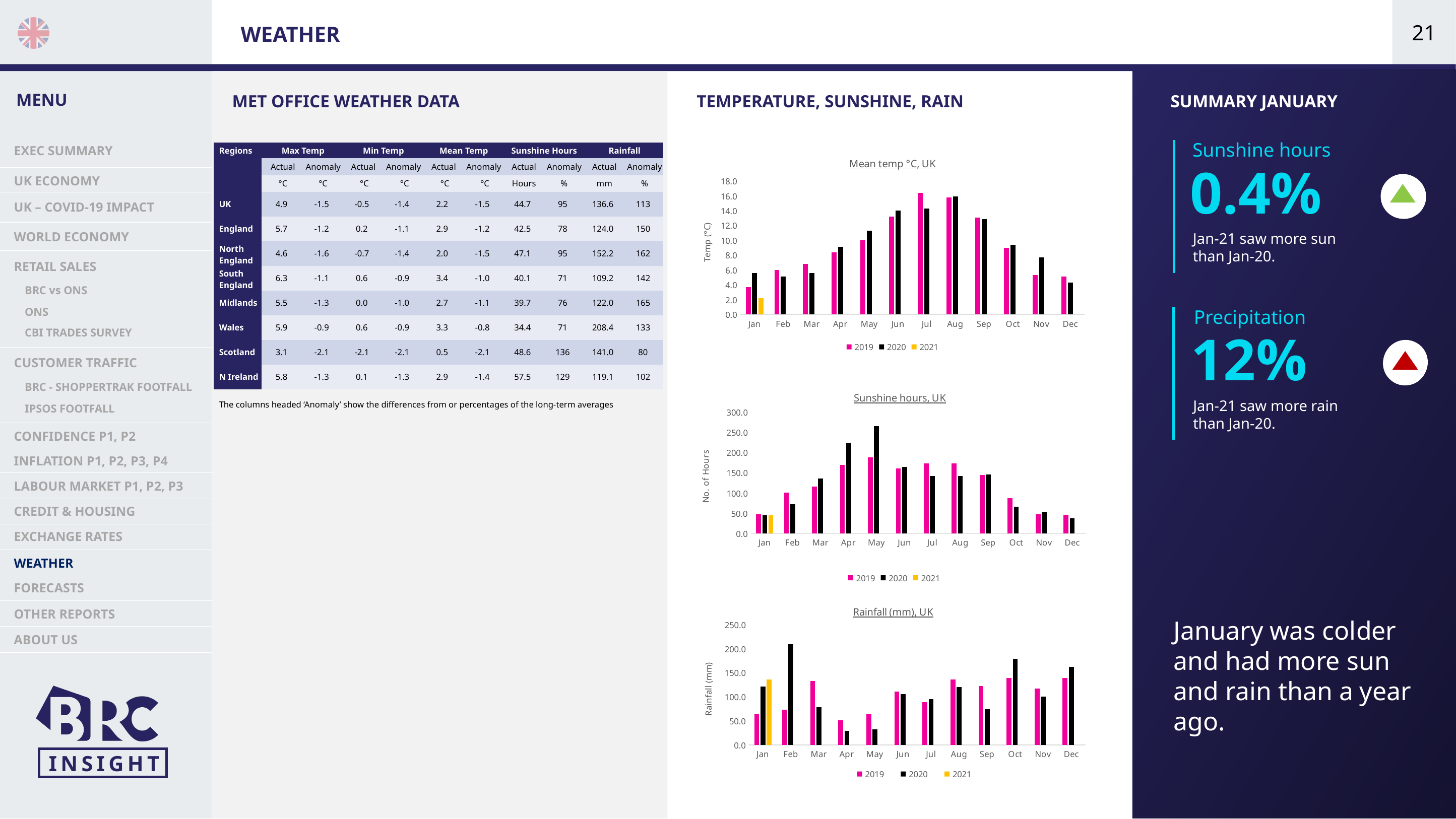
In the 'Mean temp °C, UK' chart, which month has the lowest 2019 bar? Jan In the 'Rainfall (mm), UK' chart, which month has the highest 2020 bar? Feb How many months are shown on the x axis of the 'Rainfall (mm), UK' chart? 12 In the 'Mean temp °C, UK' chart, which month has the highest 2019 bar? Jul In the 'Mean temp °C, UK' chart, is the 2021 value for Jan greater or less than 4.0? less In the 'Mean temp °C, UK' chart, is the 2019 value for Jul greater or less than 14.0? greater How many series does the legend of the 'Sunshine hours, UK' chart list? 3 In the 'Rainfall (mm), UK' chart, which is larger for Feb: the 2019 value or the 2020 value? 2020 In the 'Sunshine hours, UK' chart, is the 2020 value for May greater or less than 250.0? greater In the 'Sunshine hours, UK' chart, which month has the highest 2020 bar? May What kind of chart is the 'Mean temp °C, UK' chart? bar chart